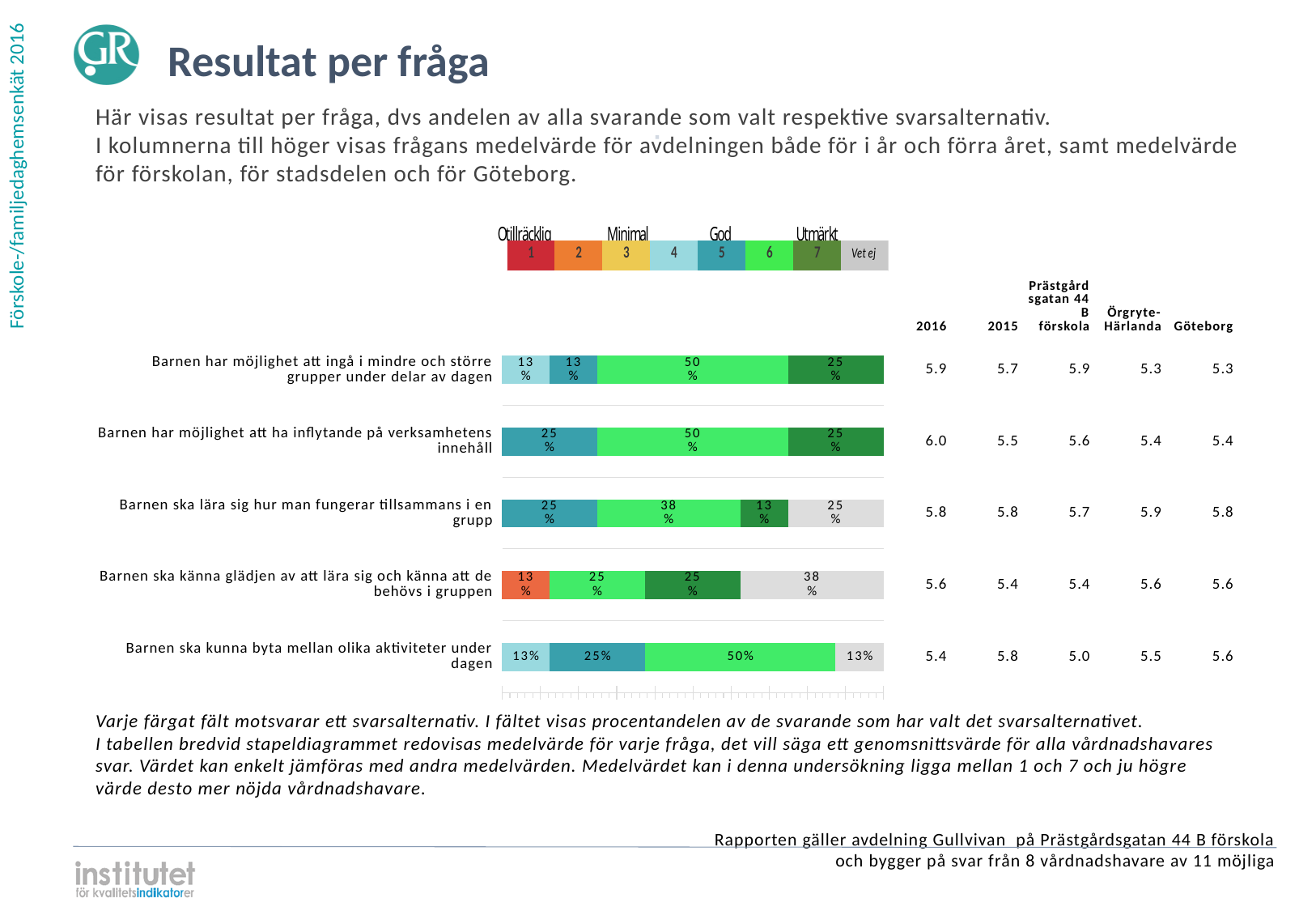
How many answer alternatives does the legend above the chart list, including 'Vet ej'? 8 What percentage chose 'Vet ej' for 'Barnen ska känna glädjen av att lära sig och känna att de behövs i gruppen'? 38% What is the 2016 mean value for 'Barnen har möjlighet att ha inflytande på verksamhetens innehåll'? 6.0 What percentage of respondents chose alternative 6 (bright green) for 'Barnen har möjlighet att ingå i mindre och större grupper under delar av dagen'? 50% For 'Barnen ska känna glädjen av att lära sig och känna att de behövs i gruppen', which is larger: the share for alternative 2 (orange) or the share for 'Vet ej'? Vet ej What percentage chose alternative 7 (dark green) for 'Barnen ska lära sig hur man fungerar tillsammans i en grupp'? 13% How many questions (bars) are shown in the chart? 5 Which question has the lowest 2016 mean value? Barnen ska kunna byta mellan olika aktiviteter under dagen What kind of chart is used to show the results per question? Stacked bar chart What is the difference between the 2016 and 2015 mean values for 'Barnen ska kunna byta mellan olika aktiviteter under dagen'? 0.4 Which question has the highest 2016 mean value? Barnen har möjlighet att ha inflytande på verksamhetens innehåll Which question is the only one with a segment for alternative 2 (orange)? Barnen ska känna glädjen av att lära sig och känna att de behövs i gruppen